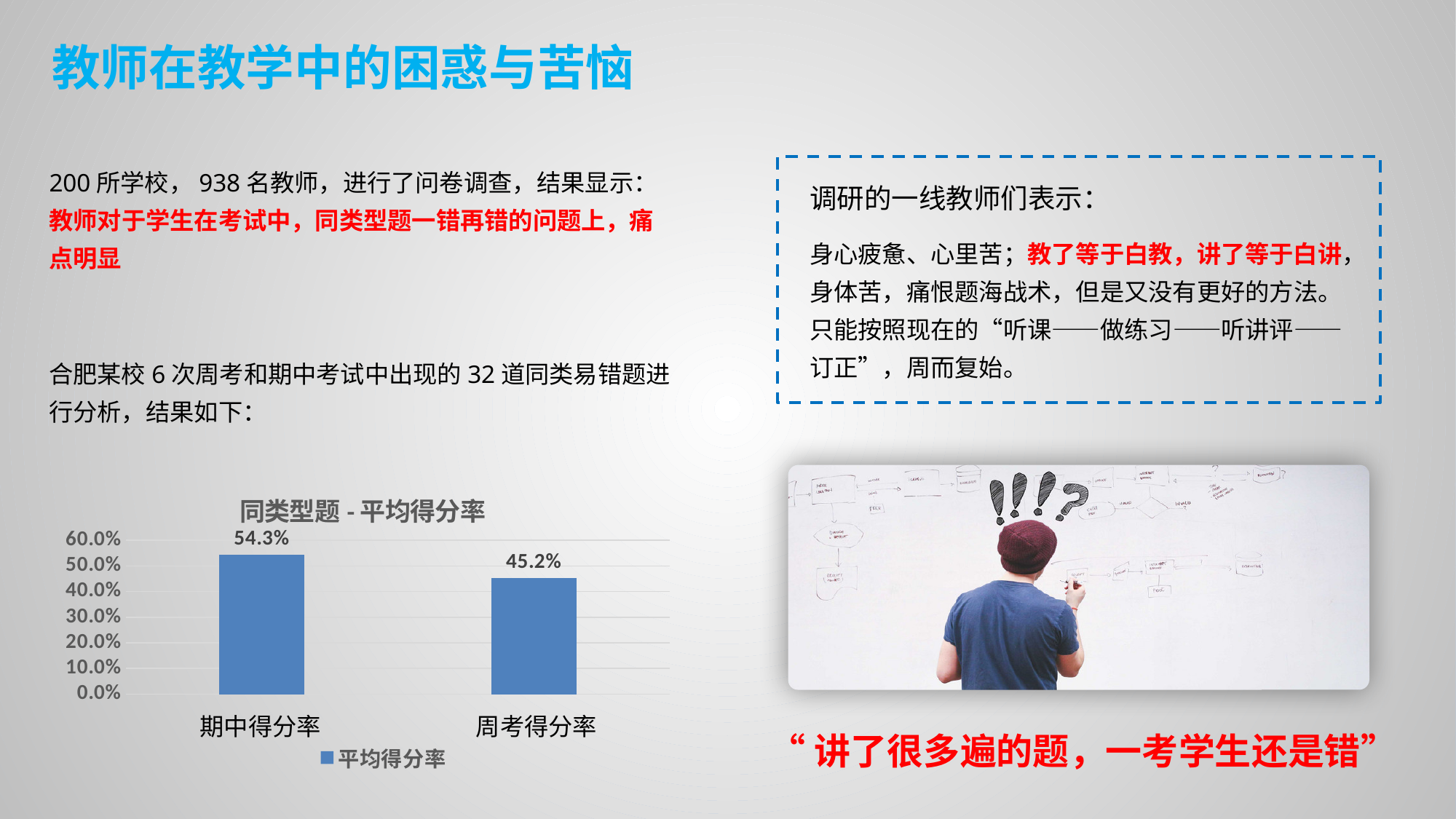
Is the value for 期中得分率 greater or less than 50.0%? greater How many series does the legend list? 1 What kind of chart is shown on the slide? bar chart What is the title of the chart? 同类型题 - 平均得分率 What is the difference between the values for 期中得分率 and 周考得分率? 9.1% What is the value for 周考得分率? 45.2% Which category has the highest value? 期中得分率 Which is larger, the value for 期中得分率 or the value for 周考得分率? 期中得分率 How many categories are shown in the chart? 2 Is the value for 周考得分率 greater or less than 50.0%? less What is the value for 期中得分率? 54.3% Which category has the lowest value? 周考得分率